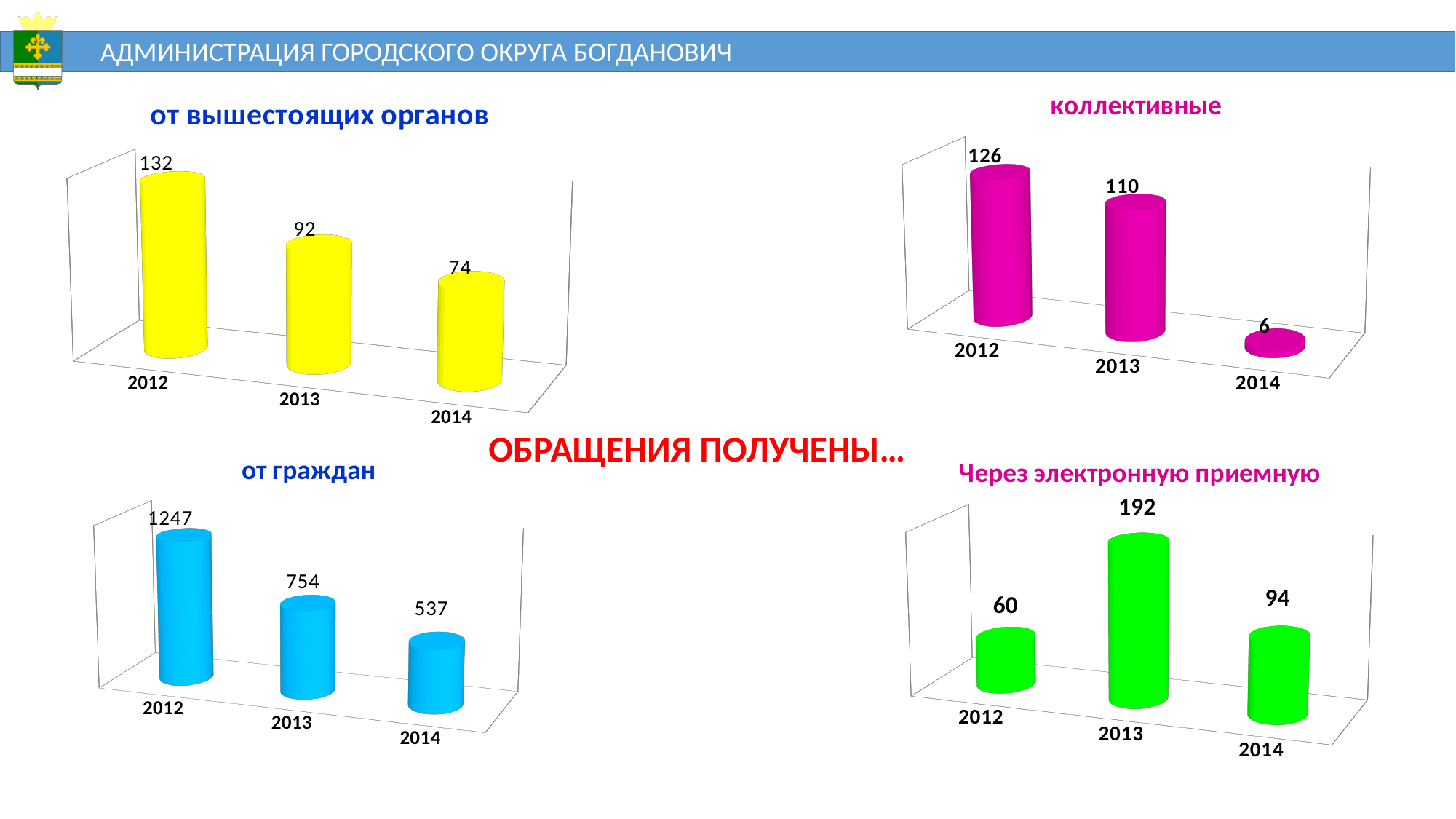
In the chart titled 'коллективные', what is the difference between the 2012 and 2013 values? 16 In the chart titled 'коллективные', what is the value for 2014? 6 How many categories (years) are shown in the chart titled 'Через электронную приемную'? 3 In the chart titled 'от вышестоящих органов', what is the value for 2012? 132 What kind of chart is the chart titled 'от граждан'? bar chart In the chart titled 'от граждан', do the values rise or fall from 2012 to 2014? fall In the chart titled 'Через электронную приемную', which is larger, the value for 2012 or the value for 2014? 2014 In the chart titled 'от граждан', what is the value for 2013? 754 In the chart titled 'от граждан', which year has the lowest value? 2014 In the chart titled 'Через электронную приемную', what is the value for 2013? 192 In the chart titled 'от вышестоящих органов', what is the difference between the 2012 and 2014 values? 58 In the chart titled 'коллективные', which year has the highest value? 2012